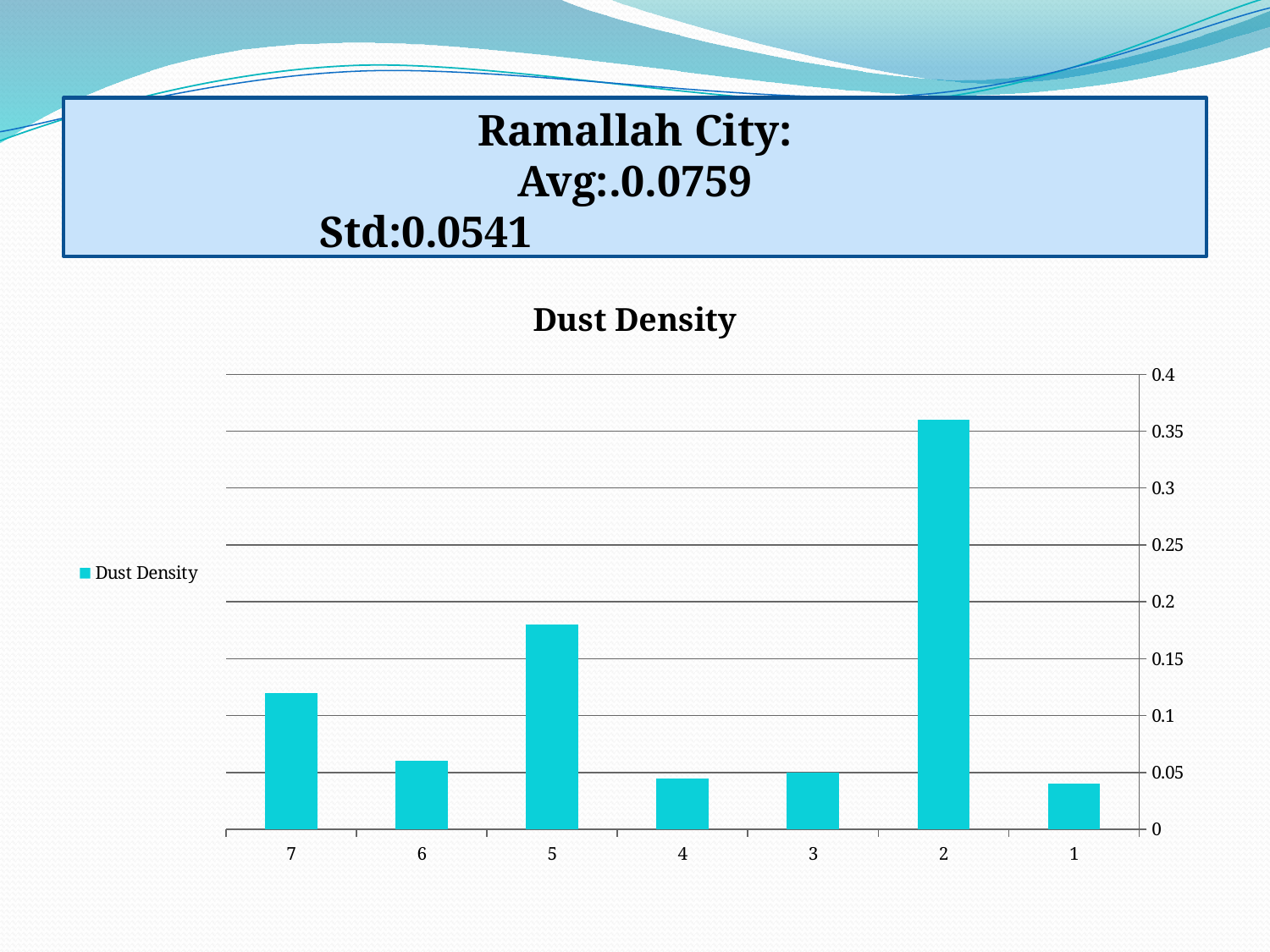
How many series does the legend list? 1 Is the value for category 5 greater or less than 0.15? greater Is the value for category 1 greater or less than 0.05? less Which category has the highest dust density? 2 Which has a larger dust density, category 5 or category 7? 5 How many categories are shown on the x axis of the chart? 7 Is the value for category 2 greater or less than 0.35? greater What is the name of the series shown in the legend? Dust Density What is the title of the chart? Dust Density What kind of chart is shown on the slide? bar chart